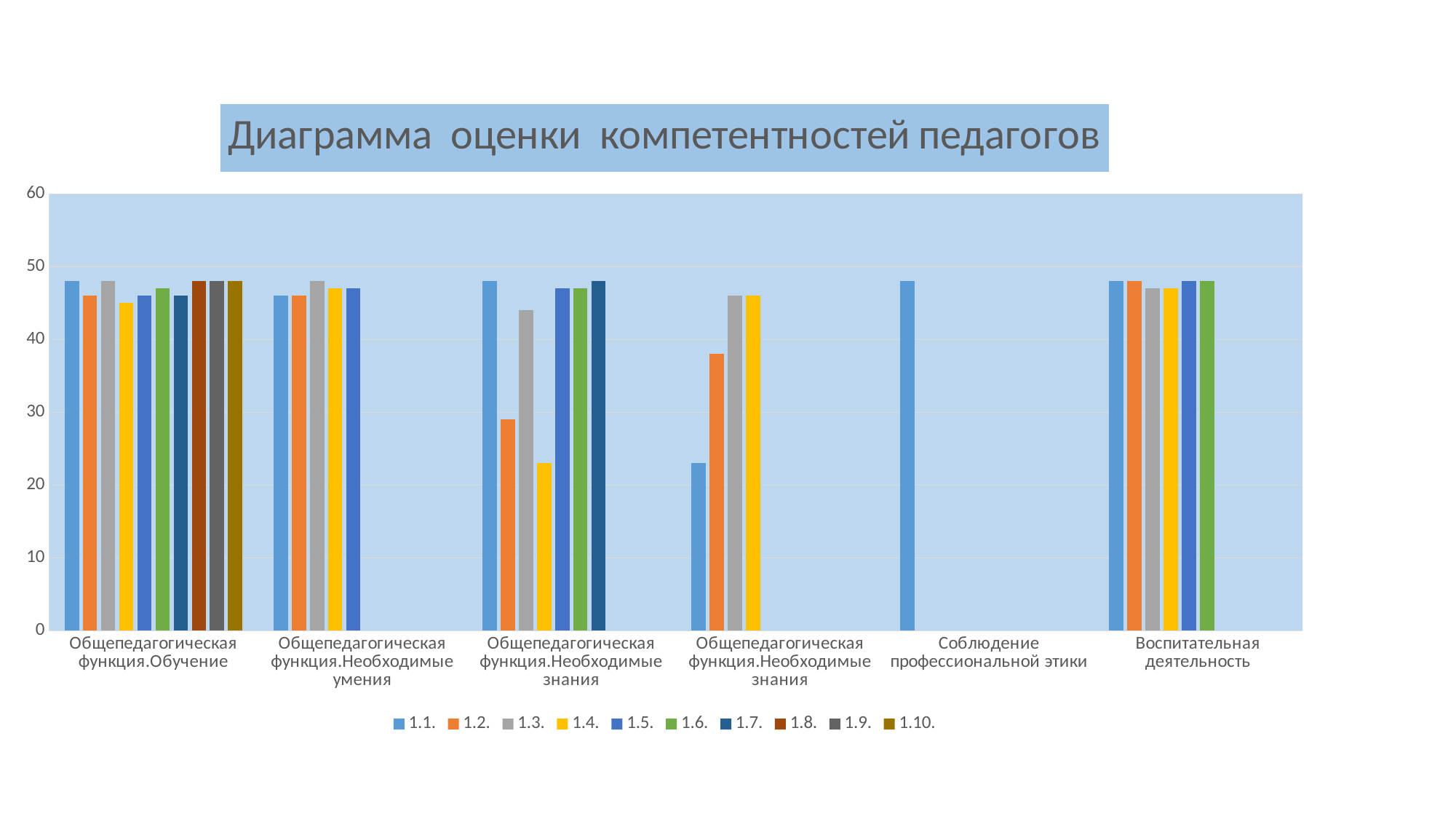
What kind of chart is shown on the slide? bar chart In the third category from the left (Общепедагогическая функция.Необходимые знания), is the value for series 1.2. greater or less than 40? less How many categories are shown along the x axis of the chart? 6 In the fourth category from the left (Общепедагогическая функция.Необходимые знания), which series has the larger value, 1.1. or 1.3.? 1.3. Is the value for series 1.1. in the category Соблюдение профессиональной этики greater or less than 40? greater In the fourth category from the left (Общепедагогическая функция.Необходимые знания), is the value for series 1.2. greater or less than 30? greater What is the title of the chart? Диаграмма оценки компетентностей педагогов How many series does the legend list? 10 Which category has a bar for only one series? Соблюдение профессиональной этики In the third category from the left (Общепедагогическая функция.Необходимые знания), which series has the larger value, 1.1. or 1.2.? 1.1.